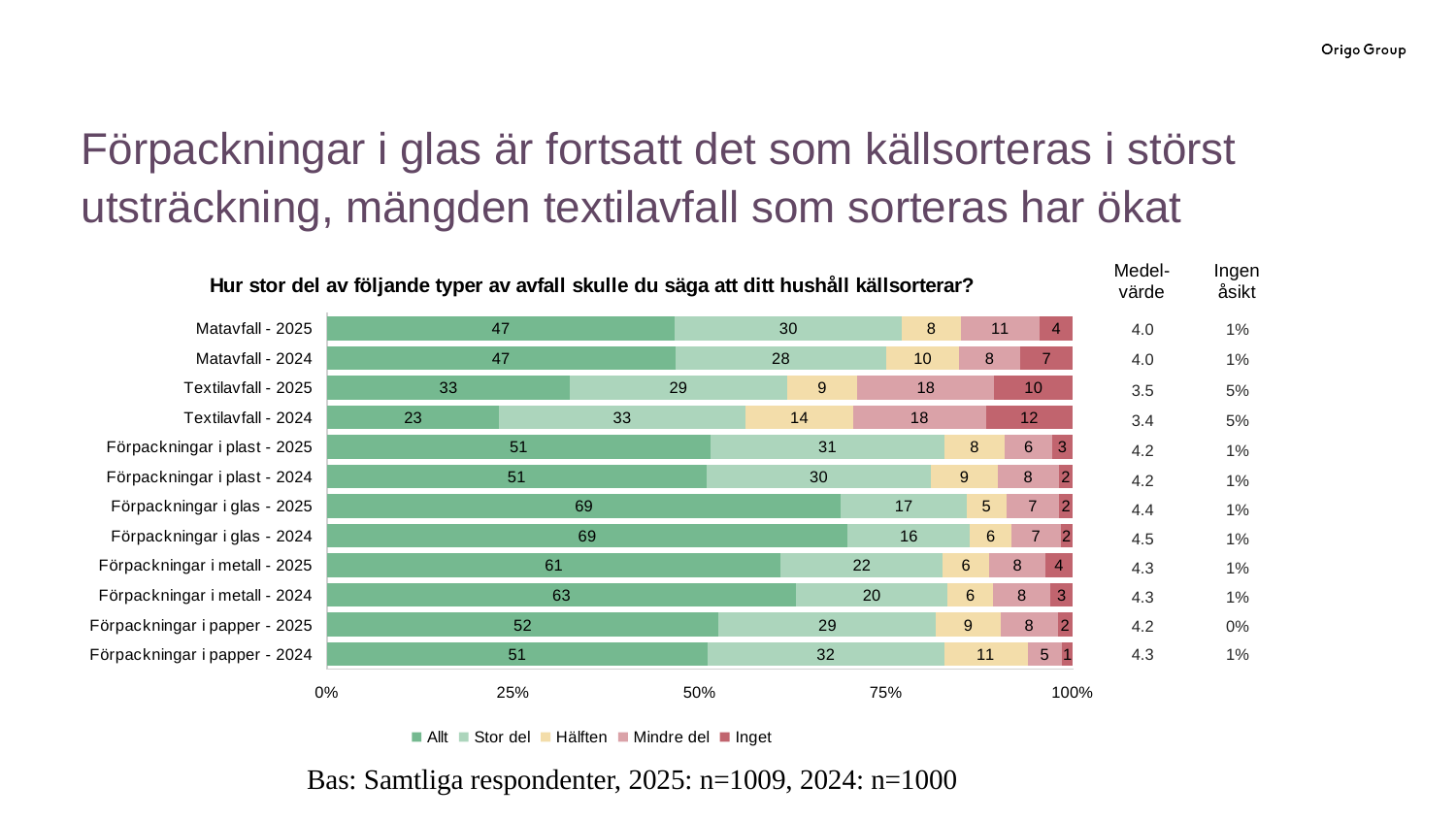
What is the total of the stacked bar for Förpackningar i plast - 2025? 99 How many series does the legend list? 5 What is the value of the "Inget" segment for Textilavfall - 2024? 12 What is the title of the chart? Hur stor del av följande typer av avfall skulle du säga att ditt hushåll källsorterar? How many categories (bars) are shown in the chart? 12 What kind of chart is shown on the slide? Stacked bar chart What is the difference between the "Allt" values for Textilavfall - 2025 and Textilavfall - 2024? 10 Which category has the lowest "Allt" value? Textilavfall - 2024 What is the value of the "Stor del" segment for Matavfall - 2024? 28 Which is larger: the "Hälften" value for Förpackningar i papper - 2024 or for Förpackningar i papper - 2025? Förpackningar i papper - 2024 What is the value of the "Allt" segment for Förpackningar i glas - 2025? 69 Which category has the highest "Mindre del" value? Textilavfall - 2025 and Textilavfall - 2024 (both 18)